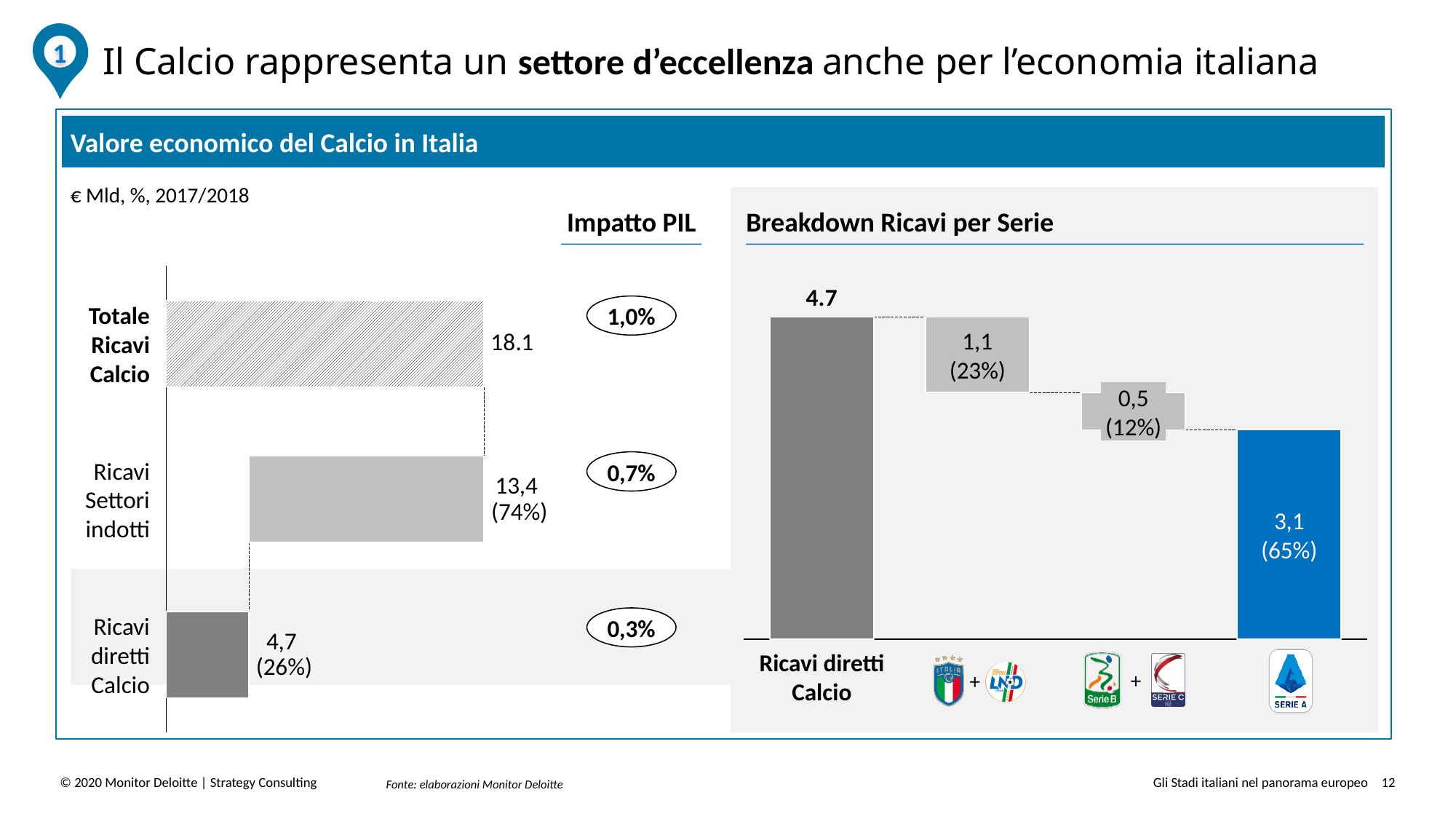
In the Breakdown Ricavi per Serie chart, what is the value of the Ricavi diretti Calcio bar? 4.7 In the left chart, which is larger, Ricavi Settori indotti or Ricavi diretti Calcio? Ricavi Settori indotti In the left chart, what is the difference between Ricavi Settori indotti (13,4) and Ricavi diretti Calcio (4,7)? 8,7 In the left chart (Valore economico del Calcio in Italia), what is the value for Totale Ricavi Calcio? 18.1 What kind of chart is the Breakdown Ricavi per Serie chart? Bar chart (waterfall) In the Breakdown Ricavi per Serie chart, what is the value shown for Serie A? 3,1 (65%) In the left chart, what is the value shown for Ricavi Settori indotti? 13,4 (74%) In the Breakdown Ricavi per Serie chart, which series has the largest share of Ricavi diretti Calcio? Serie A In the left chart, what is the Impatto PIL shown for Totale Ricavi Calcio? 1,0% In the Breakdown Ricavi per Serie chart, what is the value shown for Serie B + Serie C? 0,5 (12%) In the left chart, what is the value shown for Ricavi diretti Calcio? 4,7 (26%) In the left chart, what is the Impatto PIL shown for Ricavi Settori indotti? 0,7%